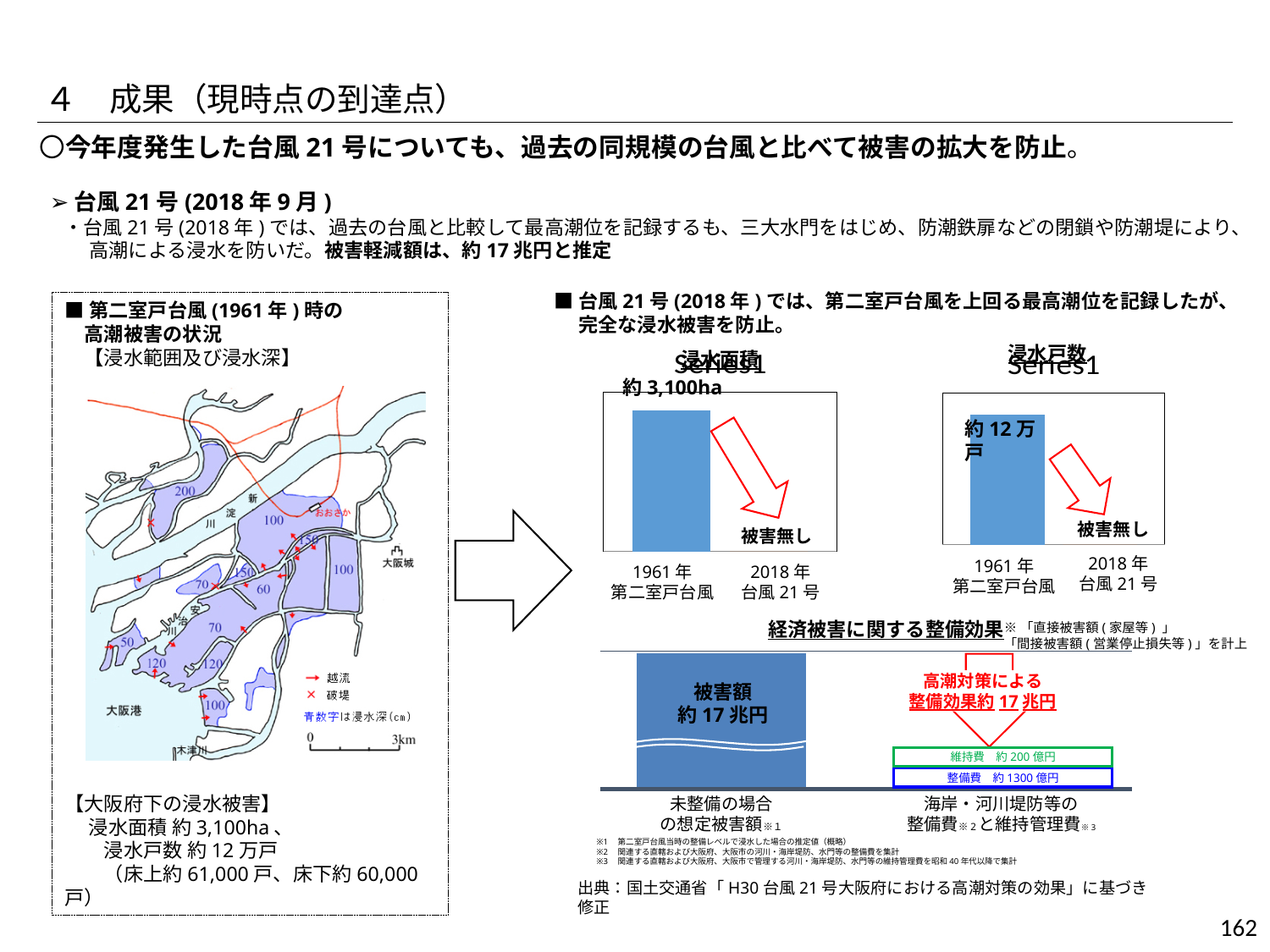
In the 経済被害に関する整備効果 diagram, what is the 被害額 for 未整備の場合? 約17兆円 In the 浸水面積 chart, what is shown for 2018年 台風21号? 被害無し What series name is displayed above the 浸水戸数 chart? Series1 What kind of chart is the 浸水面積 chart? bar chart In the 浸水面積 chart, do the values rise or fall from 1961年 to 2018年? fall In the 浸水面積 chart, what value is shown for 1961年 第二室戸台風? 約3,100ha What colour is the bar for 1961年 第二室戸台風 in the 浸水面積 chart? blue In the 浸水戸数 chart, which category has the larger value, 1961年 第二室戸台風 or 2018年 台風21号? 1961年 第二室戸台風 How many categories are on the x axis of the 浸水面積 chart? 2 In the 浸水戸数 chart, what value is shown for 1961年 第二室戸台風? 約12万戸 In the 経済被害に関する整備効果 diagram, what is the 整備費 shown? 約1300億円 In the 浸水戸数 chart, what is shown for 2018年 台風21号? 被害無し